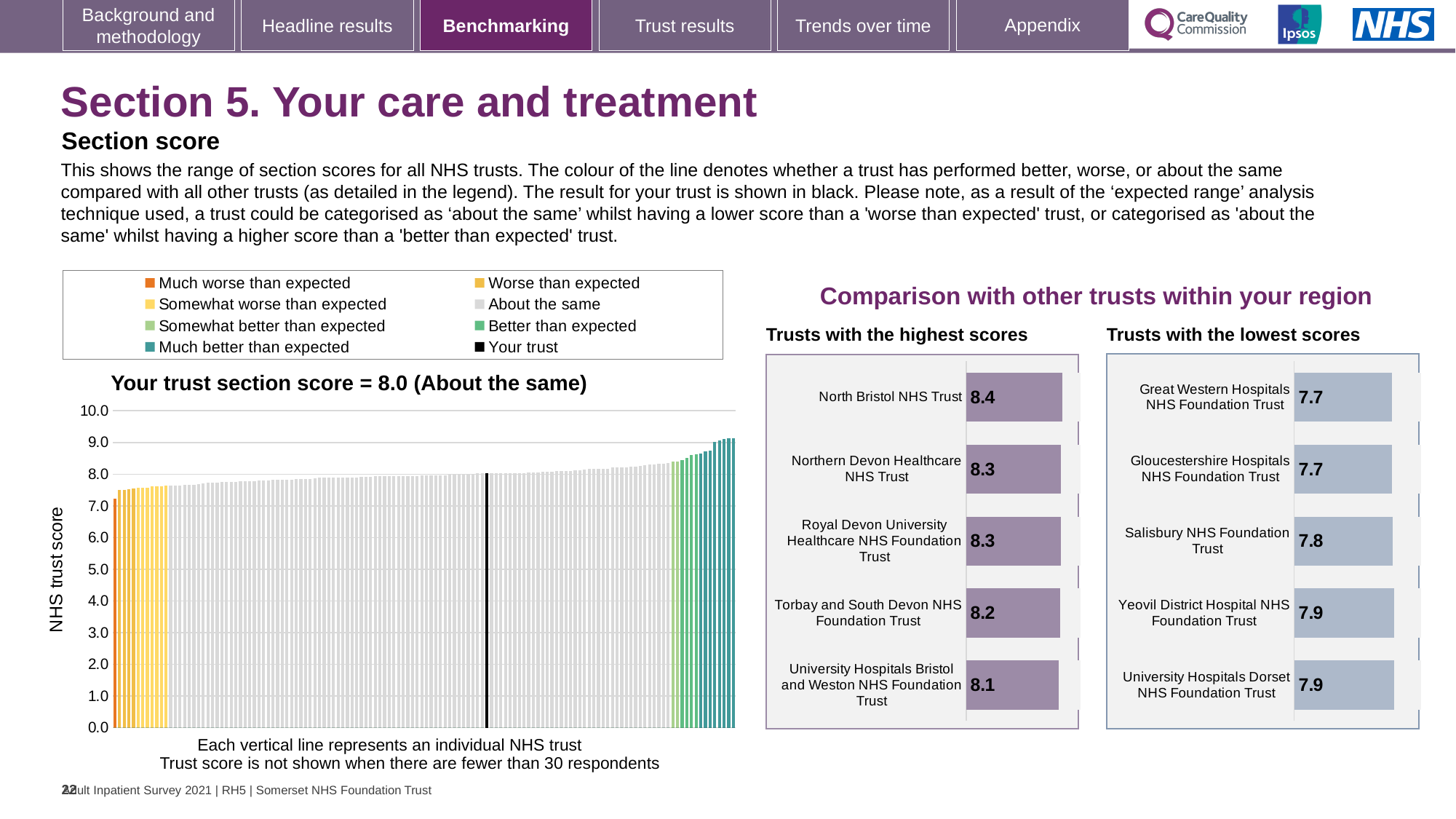
In the 'Trusts with the highest scores' chart, which trust has the highest score? North Bristol NHS Trust How many trusts are listed in the 'Trusts with the highest scores' chart? 5 In the 'Trusts with the highest scores' chart, what is the score for Torbay and South Devon NHS Foundation Trust? 8.2 How many entries does the legend above the 'Your trust section score' chart list? 8 In the 'Trusts with the lowest scores' chart, what is the difference between the scores of University Hospitals Dorset NHS Foundation Trust and Great Western Hospitals NHS Foundation Trust? 0.2 In the 'Trusts with the highest scores' chart, what is the difference between the scores of North Bristol NHS Trust and University Hospitals Bristol and Weston NHS Foundation Trust? 0.3 In the 'Trusts with the lowest scores' chart, which has the larger score: Salisbury NHS Foundation Trust or Yeovil District Hospital NHS Foundation Trust? Yeovil District Hospital NHS Foundation Trust In the 'Trusts with the lowest scores' chart, what is the score for Salisbury NHS Foundation Trust? 7.8 In the 'Your trust section score' chart, what is the section score for your trust? 8.0 What kind of chart is the 'Your trust section score' chart? bar chart In the 'Your trust section score' chart, is the value of the lowest-scoring trust (the leftmost bar) greater or less than 8.0? less In the 'Trusts with the highest scores' chart, what is the score for North Bristol NHS Trust? 8.4